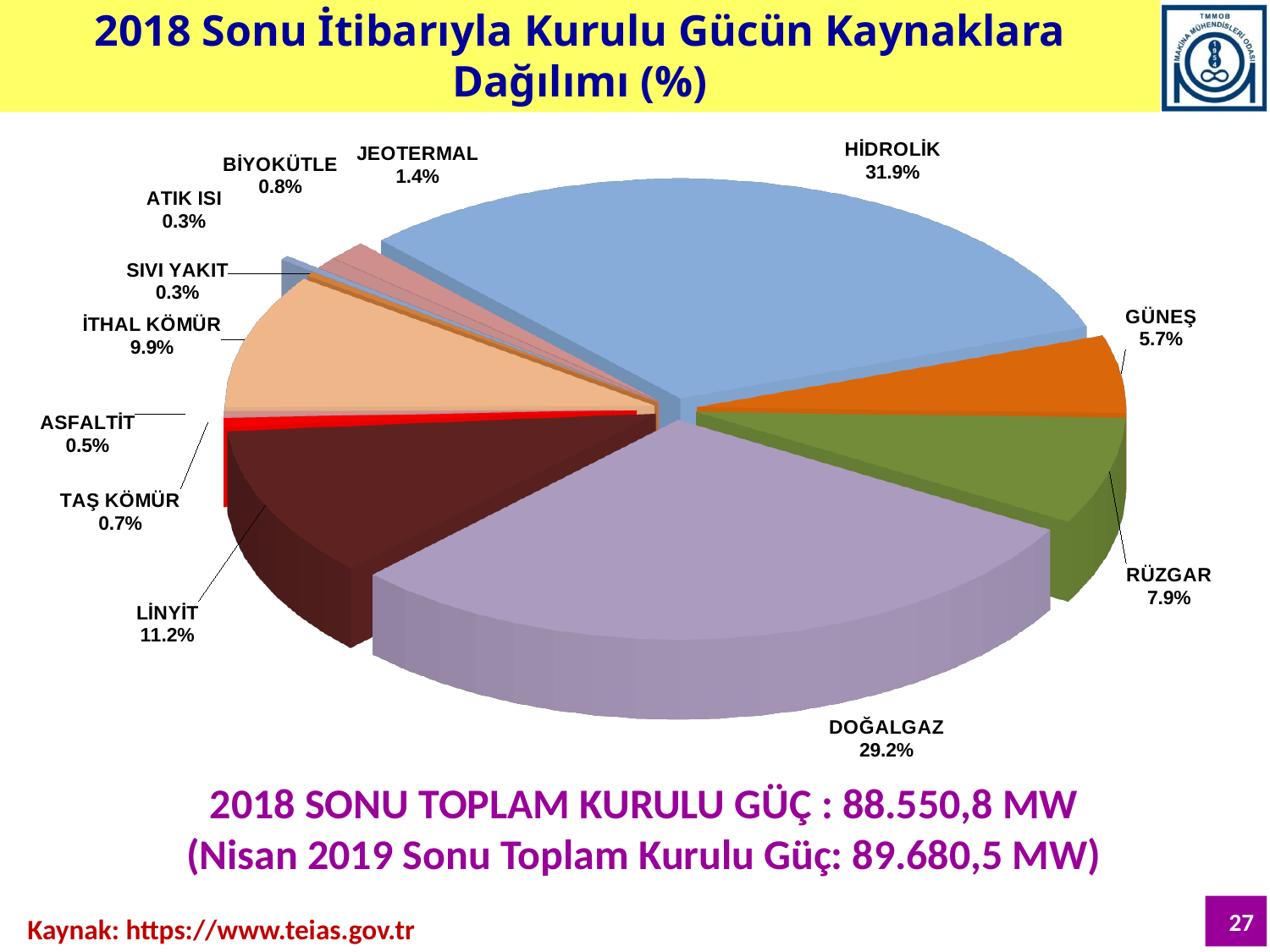
What is the difference in percentage points between LİNYİT and İTHAL KÖMÜR? 1.3 Which is larger, the share of GÜNEŞ or the share of RÜZGAR? RÜZGAR Which source has the largest share among GÜNEŞ, RÜZGAR and LİNYİT? LİNYİT What is the difference in percentage points between HİDROLİK and DOĞALGAZ? 2.7 What is the total installed capacity at the end of 2018 stated below the chart? 88.550,8 MW What percentage is shown for İTHAL KÖMÜR? 9.9% How many sources (slices) are shown in the pie chart? 12 What share of installed capacity does HİDROLİK have? 31.9% What type of chart is shown on the slide? Pie chart What is the value shown for DOĞALGAZ? 29.2% What is the value for RÜZGAR? 7.9% Which source has the largest share of the pie? HİDROLİK